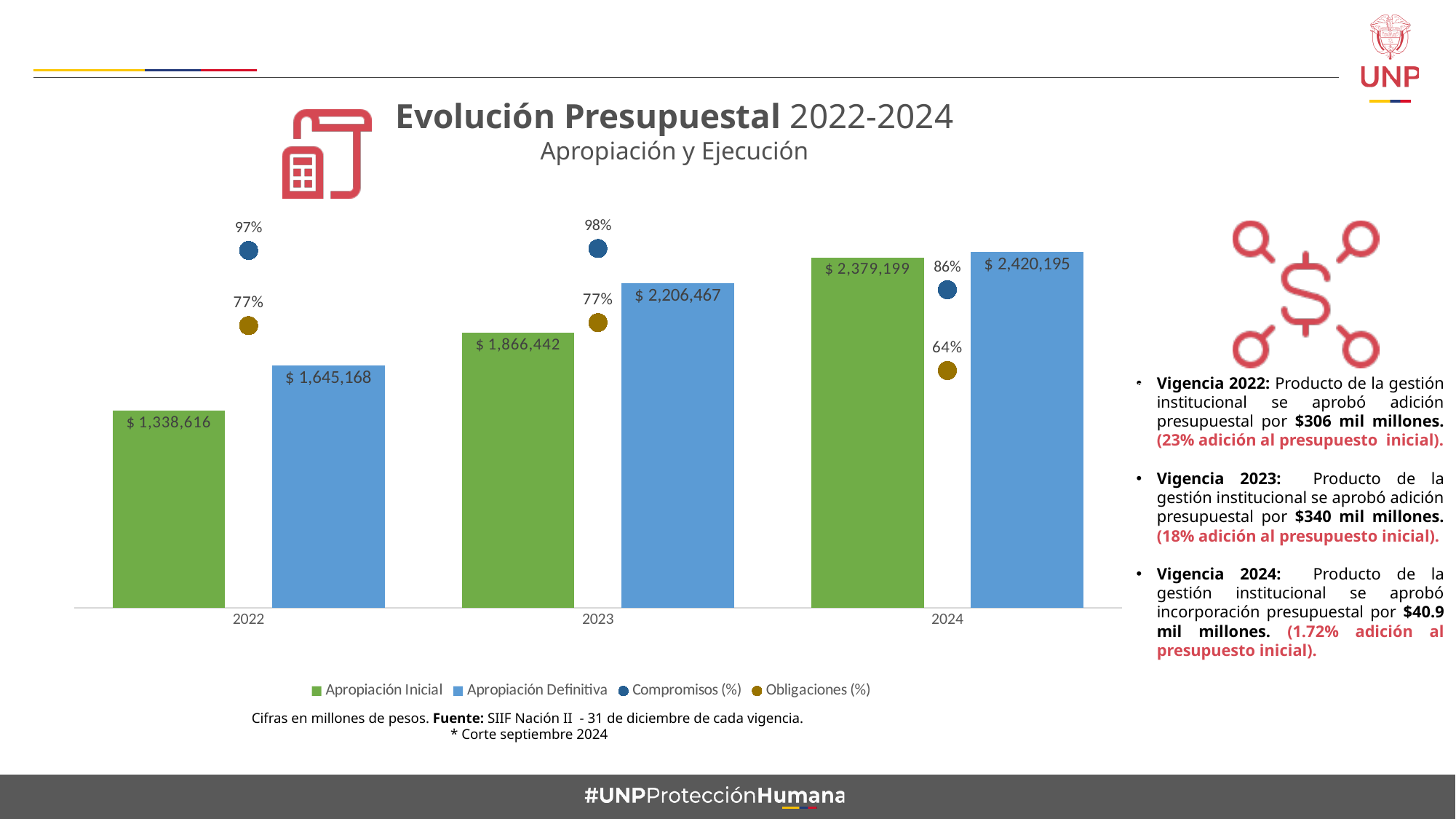
What is the Apropiación Definitiva value for 2023? $ 2,206,467 What is the difference between Apropiación Definitiva and Apropiación Inicial in 2024? $ 40,996 What is the Compromisos (%) value for 2024? 86% How many series does the chart legend list? 4 How many years are shown on the x axis of the chart? 3 Does the Apropiación Inicial rise or fall from 2022 to 2024? rise What is the difference between Apropiación Definitiva and Apropiación Inicial in 2022? $ 306,552 Which is larger, the Apropiación Inicial for 2023 or the Apropiación Definitiva for 2022? Apropiación Inicial for 2023 Which year has the lowest Obligaciones (%)? 2024 What is the Apropiación Inicial value for 2022? $ 1,338,616 Which year has the highest Apropiación Definitiva? 2024 What is the Obligaciones (%) value for 2022? 77%